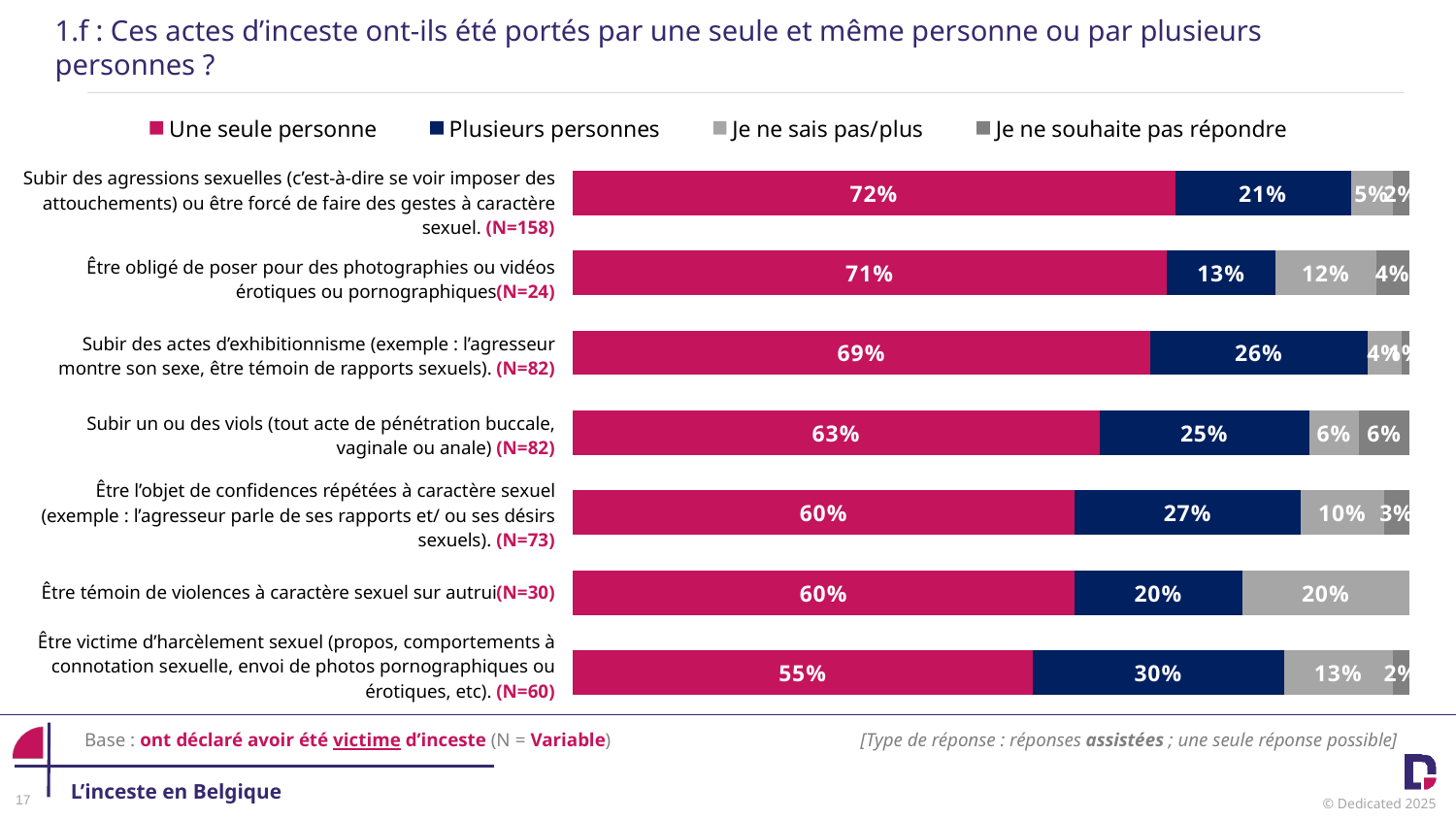
What is the value of "Plusieurs personnes" for "Être victime d'harcèlement sexuel" (N=60)? 30% Which is larger: the "Plusieurs personnes" value for "Subir des actes d'exhibitionnisme" or for "Être obligé de poser pour des photographies ou vidéos"? Subir des actes d'exhibitionnisme (26%) Which category has the lowest value for "Une seule personne"? Être victime d'harcèlement sexuel (N=60) What is the value of "Une seule personne" for "Subir des agressions sexuelles" (N=158)? 72% How many categories (types of acts) are plotted in the chart? 7 What is the difference between the "Une seule personne" values for "Subir des agressions sexuelles" (72%) and "Être victime d'harcèlement sexuel" (55%)? 17% What kind of chart is shown on the slide? Stacked bar chart What is the value of "Je ne sais pas/plus" for "Être obligé de poser pour des photographies ou vidéos érotiques ou pornographiques" (N=24)? 12% What is the value of "Plusieurs personnes" for "Être l'objet de confidences répétées à caractère sexuel" (N=73)? 27% How many series does the legend list? 4 Which category has the highest value for "Une seule personne"? Subir des agressions sexuelles (N=158) Which legend entry is shown in pink/magenta? Une seule personne